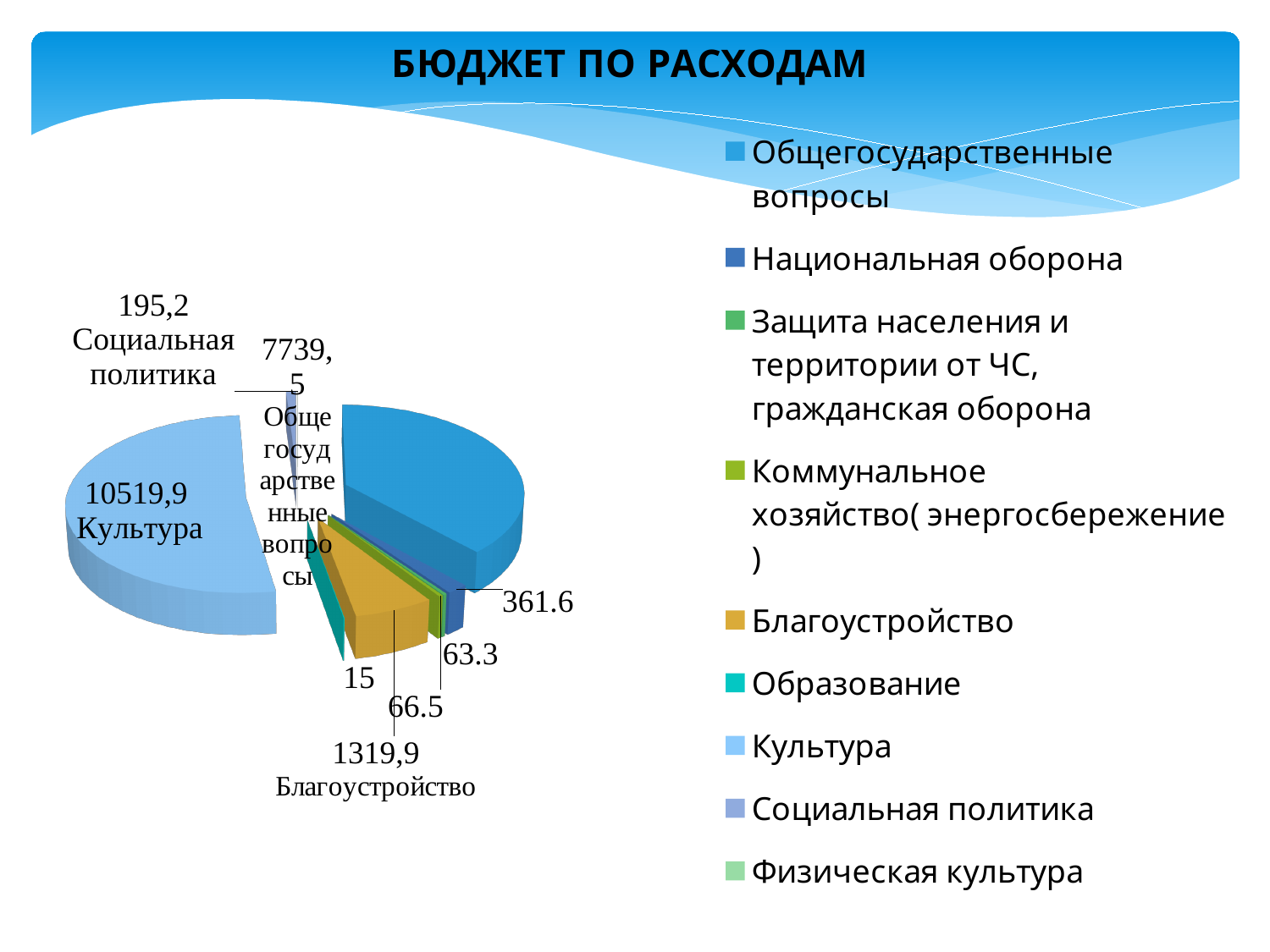
Which is larger, Культура or Общегосударственные вопросы? Культура How many entries does the chart's legend list? 9 What is the value shown for Общегосударственные вопросы? 7739,5 What is the difference between the values for Благоустройство and Социальная политика? 1124,7 What kind of chart is shown on the slide? pie chart What is the value shown for Культура? 10519,9 What is the value shown for Национальная оборона? 361.6 What is the title of the chart on the slide? БЮДЖЕТ ПО РАСХОДАМ Which category has the largest slice of the pie? Культура What is the difference between the values for Культура and Общегосударственные вопросы? 2780,4 What is the value shown for Благоустройство? 1319,9 What is the value shown for Социальная политика? 195,2